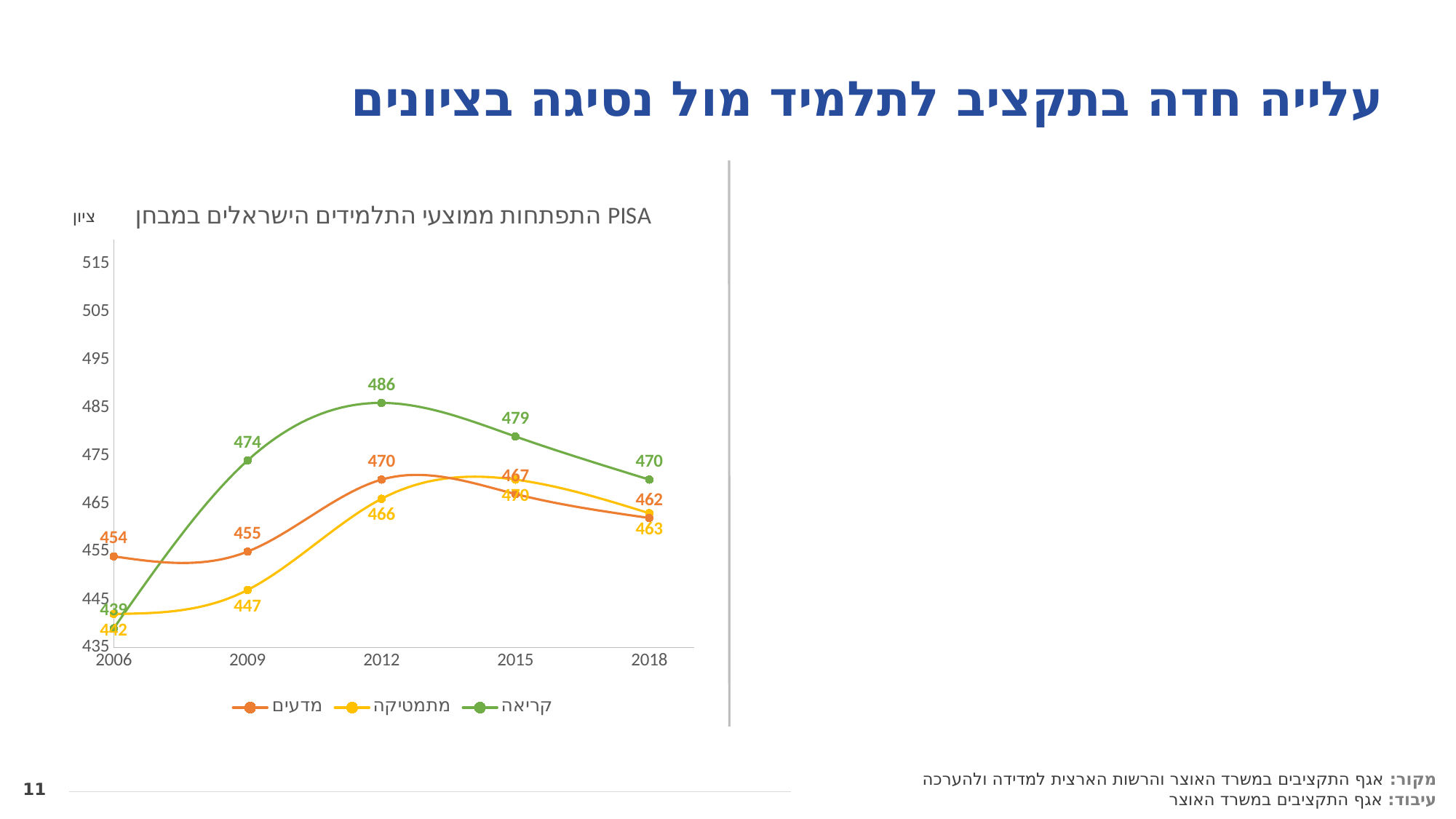
What is the value for קריאה (reading) in 2012? 486 What kind of chart is shown on the slide? line chart In which year does the קריאה (reading) series reach its highest value? 2012 In 2009, which is larger: the value for קריאה (reading) or for מדעים (science)? קריאה (reading) What is the difference between the קריאה (reading) values in 2012 and 2018? 16 What is the value for מדעים (science) in 2018? 462 Does the קריאה (reading) series rise or fall from 2012 to 2018? fall How many years are plotted along the x axis? 5 In which year is the קריאה (reading) value lowest? 2006 What is the value for קריאה (reading) in 2009? 474 How many series does the legend list? 3 What is the value for מדעים (science) in 2006? 454